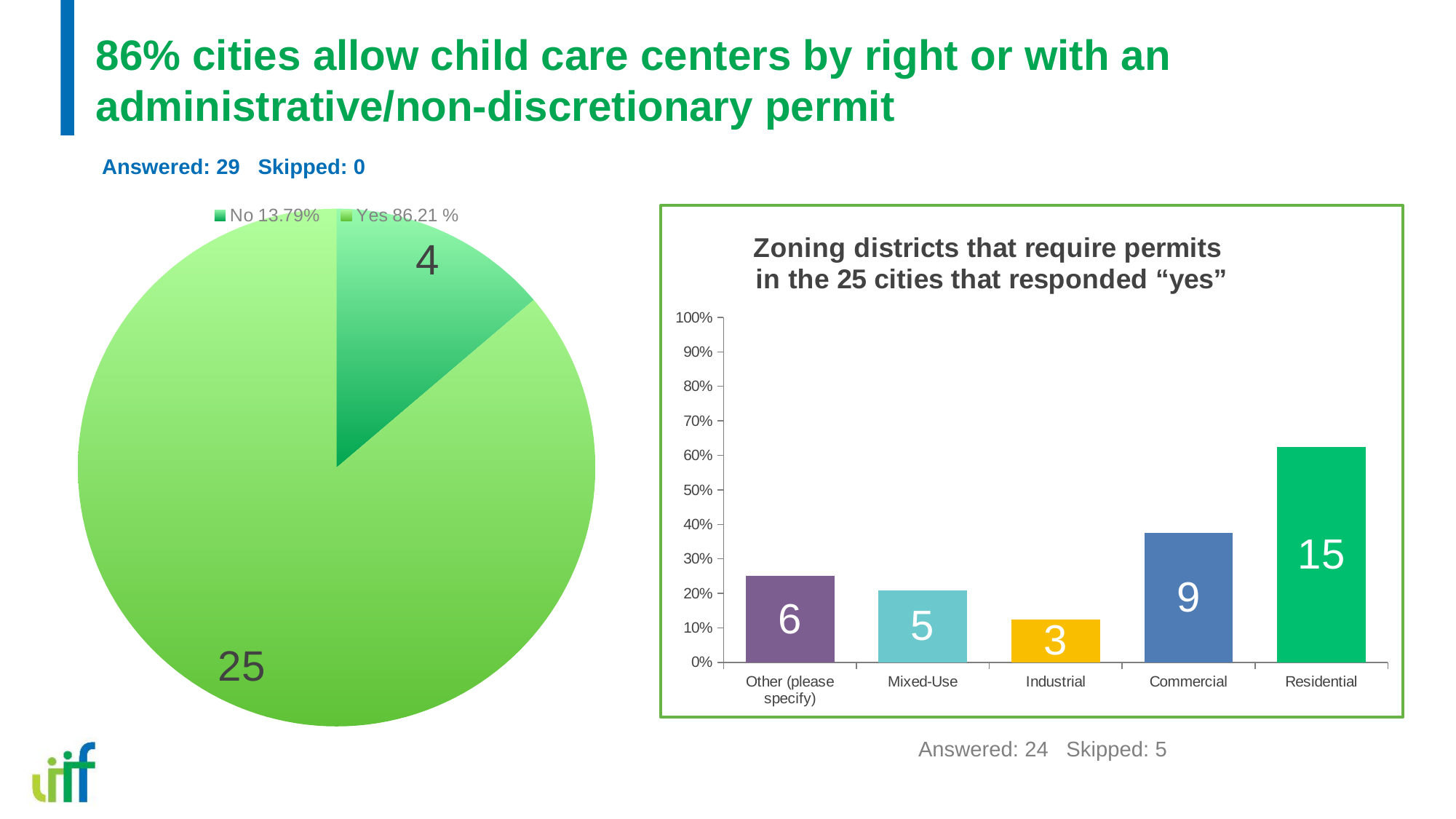
In the pie chart on the left, what percentage share does the legend give for "Yes"? 86.21 % In the chart titled "Zoning districts that require permits in the 25 cities that responded 'yes'", what is the difference between the Residential and Commercial values? 6 In the chart titled "Zoning districts that require permits in the 25 cities that responded 'yes'", how many categories are shown on the x axis? 5 In the chart titled "Zoning districts that require permits in the 25 cities that responded 'yes'", which category has the lowest value? Industrial In the pie chart on the left, what is the value shown for the "No" slice? 4 What kind of chart is the chart on the right side of the slide? Bar chart In the pie chart on the left, which slice is larger, "Yes" or "No"? Yes In the chart titled "Zoning districts that require permits in the 25 cities that responded 'yes'", what is the value for Residential? 15 In the pie chart on the left, what is the value shown for the "Yes" slice? 25 In the chart titled "Zoning districts that require permits in the 25 cities that responded 'yes'", which category has the highest value? Residential In the pie chart on the left, what percentage share does the legend give for "No"? 13.79% In the chart titled "Zoning districts that require permits in the 25 cities that responded 'yes'", what is the value for Industrial? 3